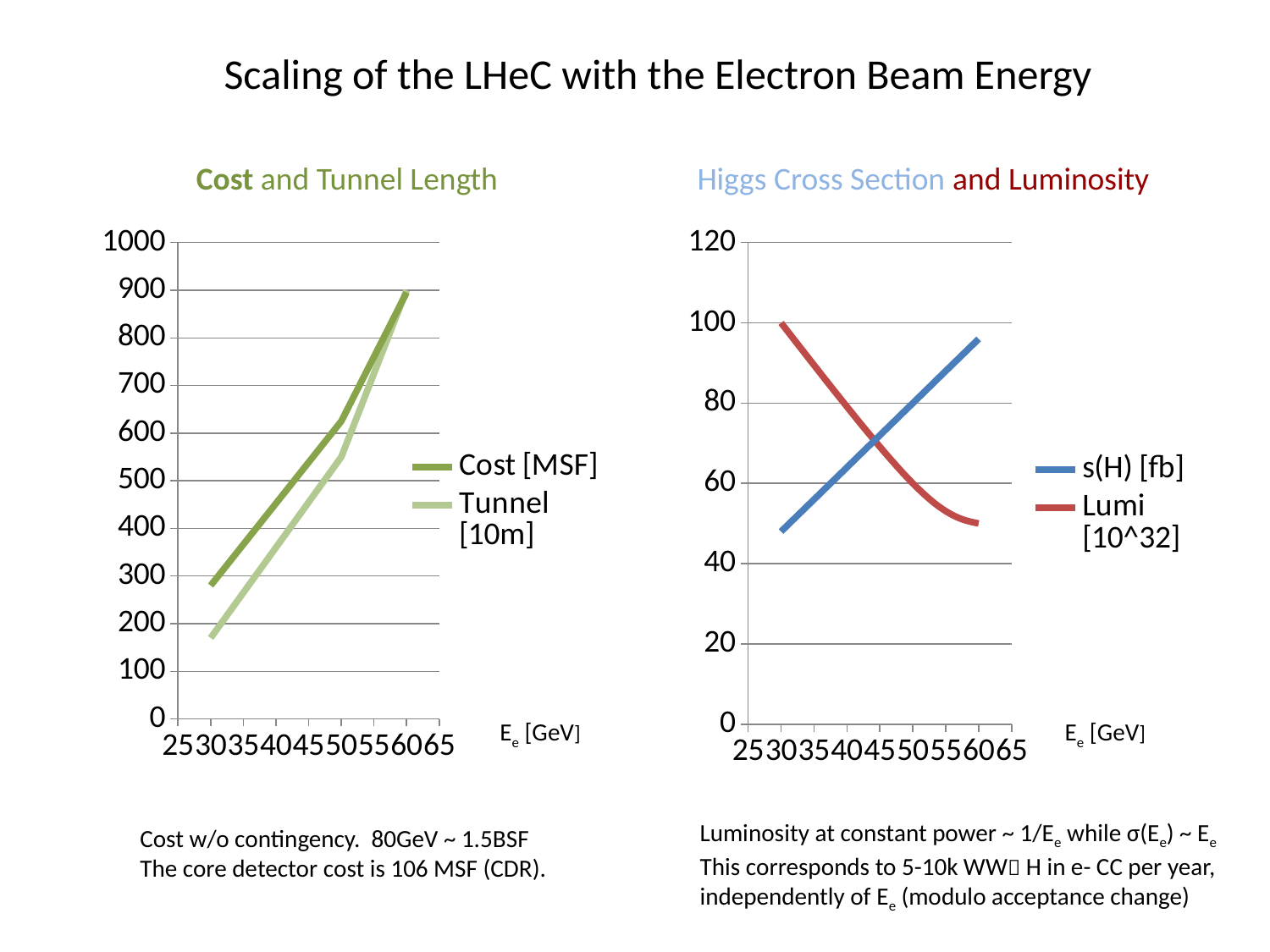
What kind of chart is the 'Cost and Tunnel Length' chart? line chart In the 'Cost and Tunnel Length' chart, does the Cost [MSF] series rise or fall as the electron beam energy increases? rise What is the x-axis label of the 'Higgs Cross Section and Luminosity' chart? Ee [GeV] In the 'Cost and Tunnel Length' chart, which series has the larger value at 30 GeV, Cost [MSF] or Tunnel [10m]? Cost [MSF] How many series does the legend of the 'Higgs Cross Section and Luminosity' chart list? 2 In the 'Cost and Tunnel Length' chart, is the Cost [MSF] value at 30 GeV greater or less than 200? greater In the 'Higgs Cross Section and Luminosity' chart, which series has the larger value at 60 GeV, s(H) [fb] or Lumi [10^32]? s(H) [fb] In the 'Cost and Tunnel Length' chart, is the Cost [MSF] value at 60 GeV greater or less than 800? greater In the 'Cost and Tunnel Length' chart, is the Tunnel [10m] value at 30 GeV greater or less than 300? less In the 'Higgs Cross Section and Luminosity' chart, does the Lumi [10^32] series rise or fall as the electron beam energy increases? fall How many series does the legend of the 'Cost and Tunnel Length' chart list? 2